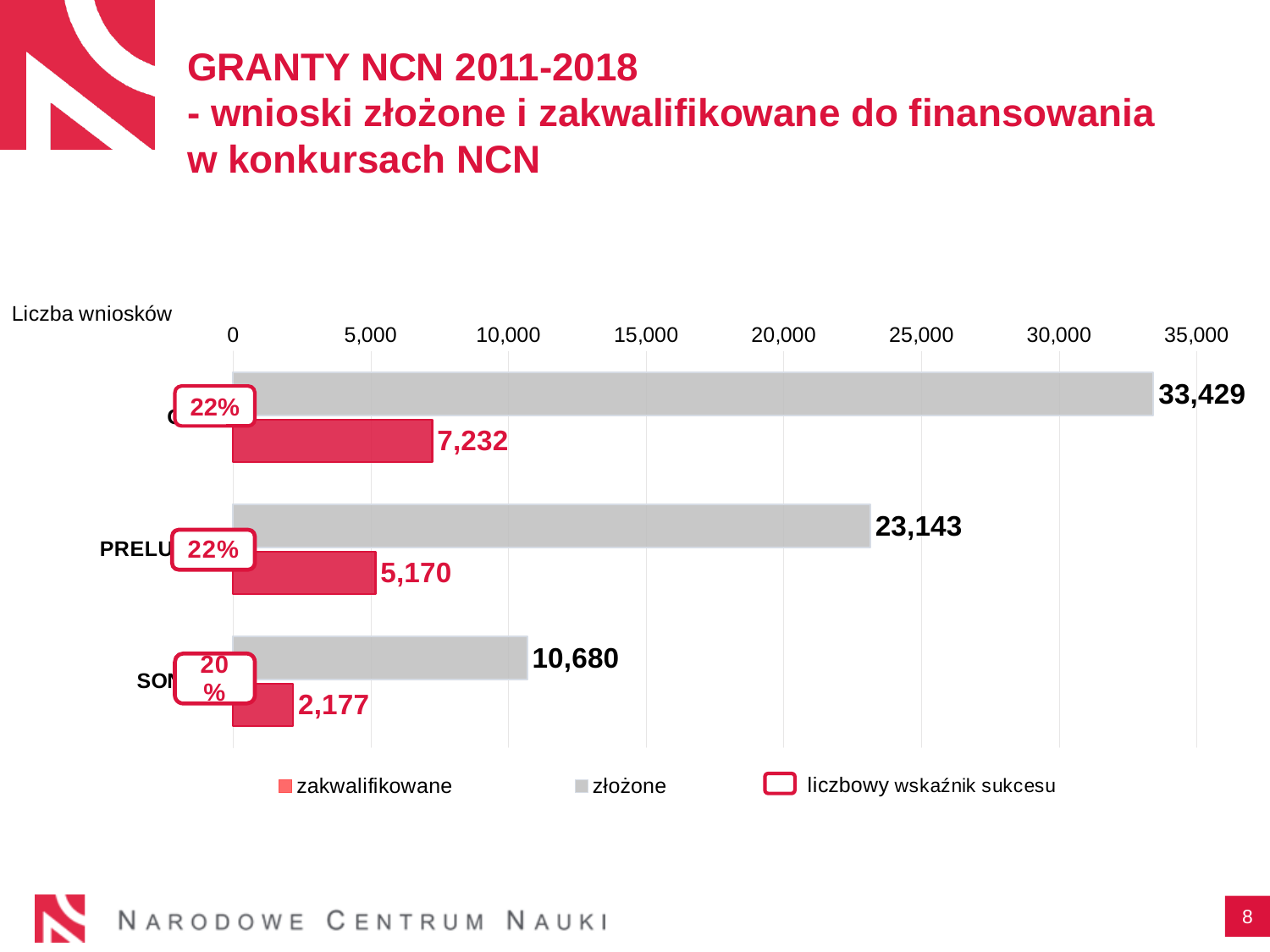
How many categories are plotted in the chart? 3 What is the difference between the 'złożone' and 'zakwalifikowane' values for the middle category? 17,973 Which is larger: the 'zakwalifikowane' value for the middle category or for the bottom category? the middle category Which category has the highest 'złożone' value? the top category What is the 'zakwalifikowane' value for the middle category in the chart? 5,170 What is the axis title shown above the chart's value axis? Liczba wniosków What is the 'złożone' value for the top category in the chart? 33,429 What kind of chart is shown on the slide? bar chart What success rate (liczbowy wskaźnik sukcesu) is shown for the bottom category? 20% What is the difference between the 'złożone' and 'zakwalifikowane' values for the top category? 26,197 What is the 'złożone' value for the bottom category in the chart? 10,680 How many entries does the chart legend list? 3